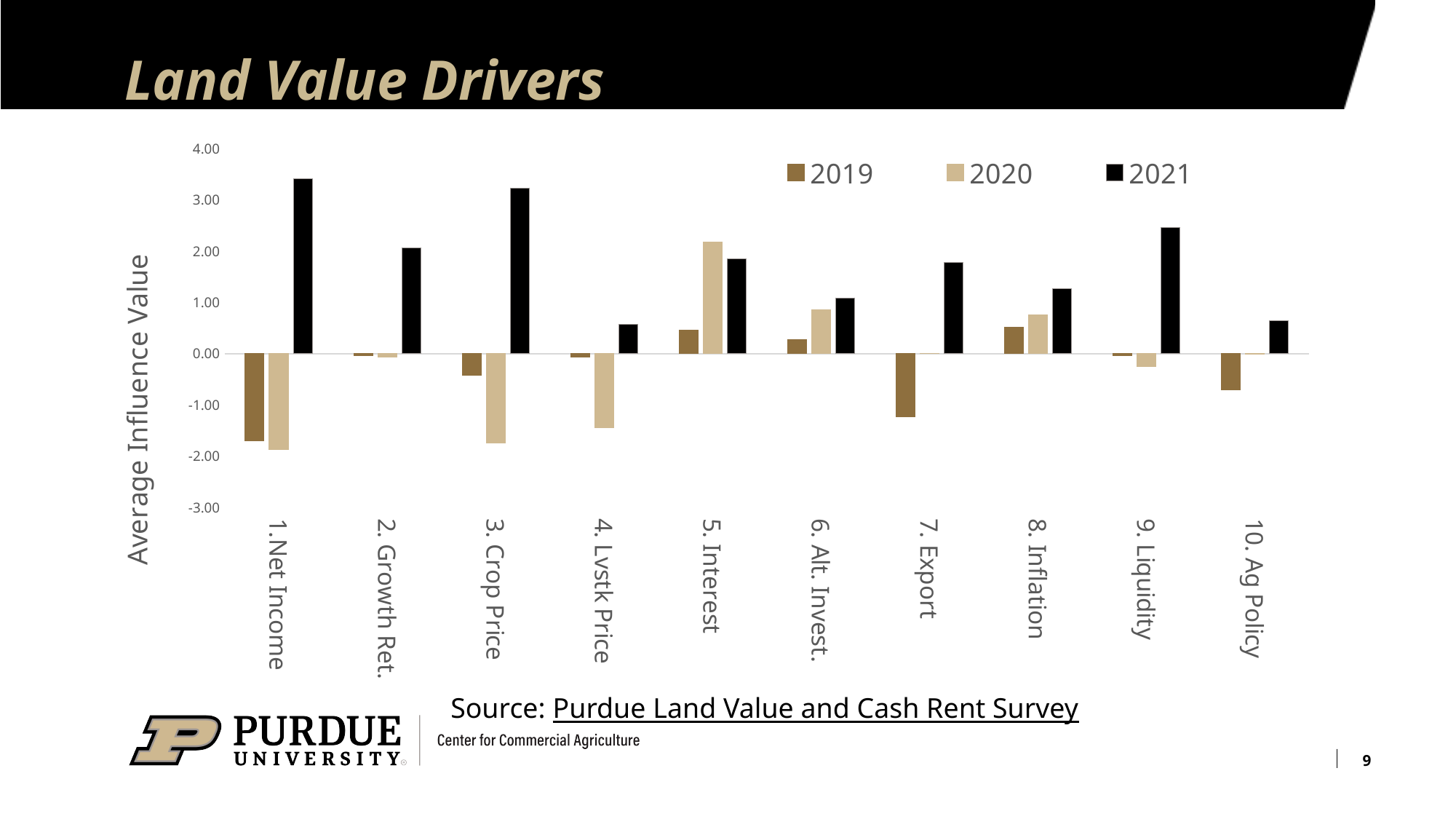
How many series does the legend list? 3 Is the 2020 value for 5. Interest greater or less than 2.00? greater What is the title of the vertical axis? Average Influence Value Is the 2021 value for 9. Liquidity greater or less than 2.00? greater Is the 2019 value for 7. Export greater or less than -1.00? less For 5. Interest, which series has the larger value, 2020 or 2021? 2020 What kind of chart is shown on the slide? bar chart How many land value driver categories are shown on the x axis? 10 Which category has the lowest 2019 value? 1. Net Income Which has the larger 2021 value, 2. Growth Ret. or 9. Liquidity? 9. Liquidity Which category has the highest 2020 value? 5. Interest